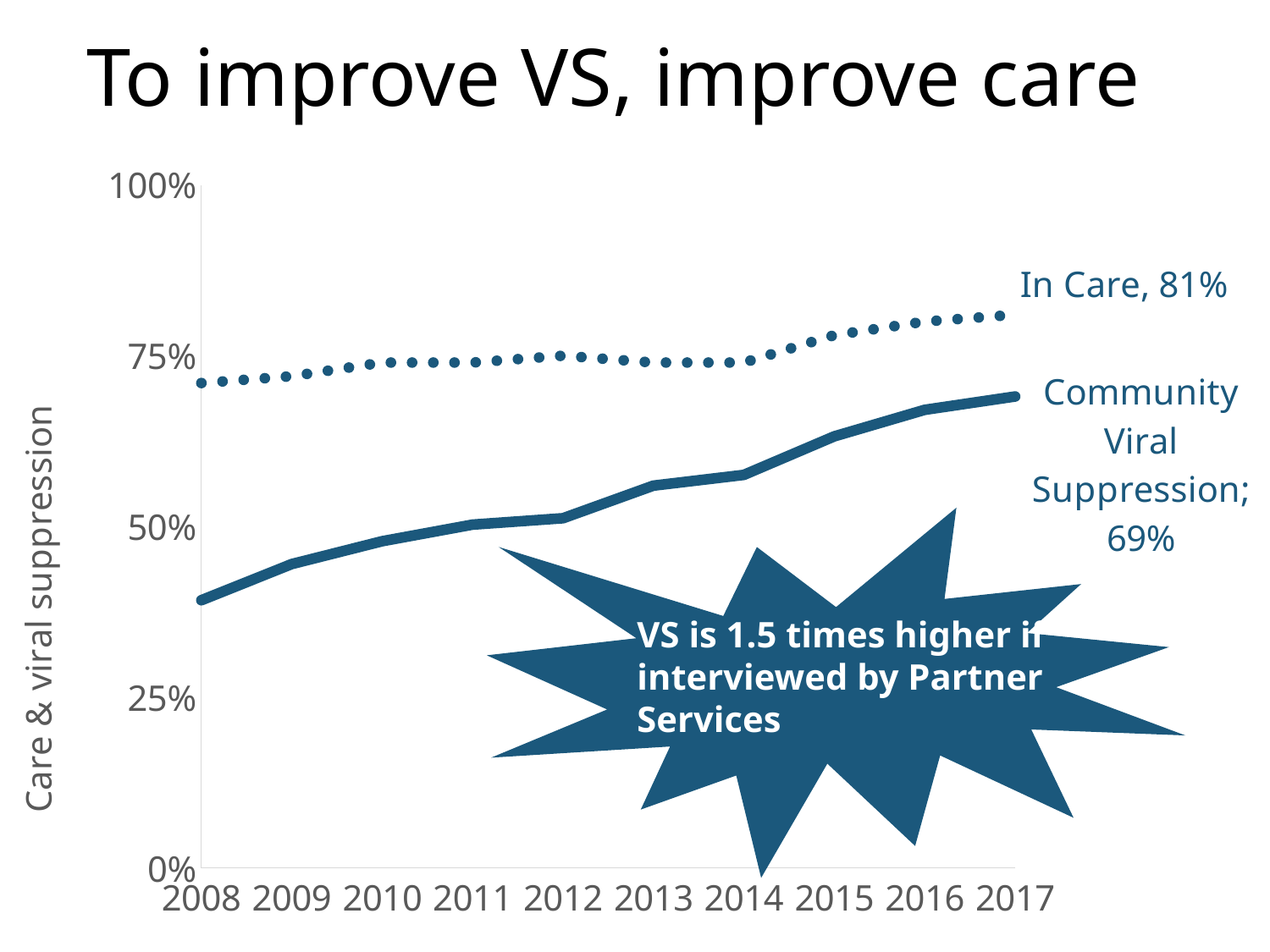
Which series has the higher value in 2017, In Care or Community Viral Suppression? In Care What is the value for In Care in 2017? 81% What is the difference between the In Care value and the Community Viral Suppression value in 2017? 12 percentage points What kind of chart is shown on the slide? Line chart Is the value for Community Viral Suppression in 2008 greater or less than 50%? less What is the value for Community Viral Suppression in 2017? 69% How many years are shown on the x axis? 10 Does the Community Viral Suppression line rise or fall from 2008 to 2017? Rise How many series are plotted on the chart? 2 Is the value for In Care in 2008 greater or less than 50%? greater Is the value for Community Viral Suppression in 2014 greater or less than 50%? greater What is the title of the y axis? Care & viral suppression